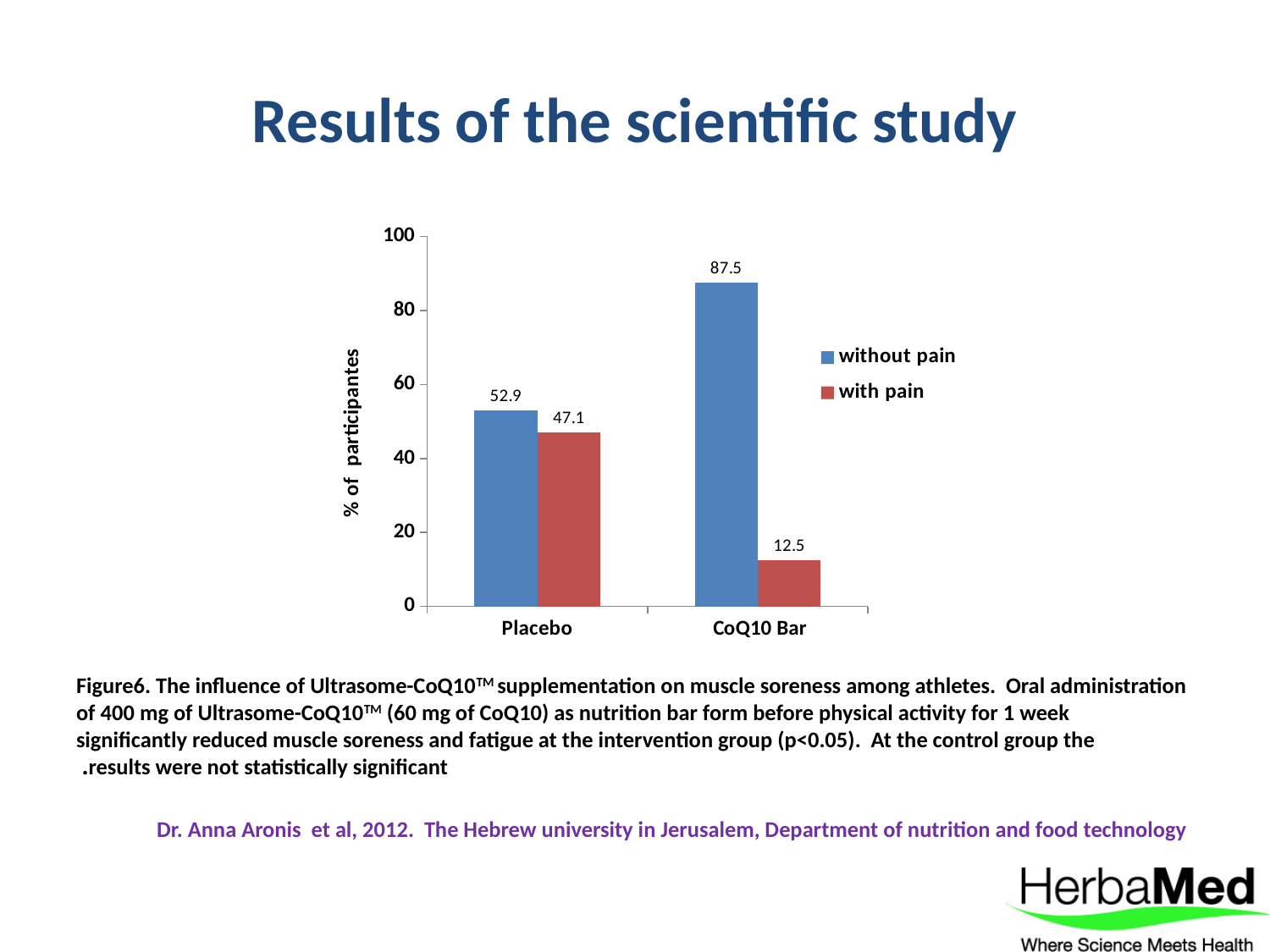
Which is larger: the 'with pain' value for Placebo or for CoQ10 Bar? Placebo What is the value for 'with pain' in the Placebo group? 47.1 Which group has the highest 'without pain' value? CoQ10 Bar What is the label of the y axis? % of participantes What is the value for 'without pain' in the CoQ10 Bar group? 87.5 What is the difference between the 'without pain' values for CoQ10 Bar and Placebo? 34.6 Which group has the lowest 'with pain' value? CoQ10 Bar What is the difference between the 'without pain' and 'with pain' values in the CoQ10 Bar group? 75 What is the value for 'without pain' in the Placebo group? 52.9 What kind of chart is shown on the slide? Bar chart How many series does the legend list? 2 What is the value for 'with pain' in the CoQ10 Bar group? 12.5